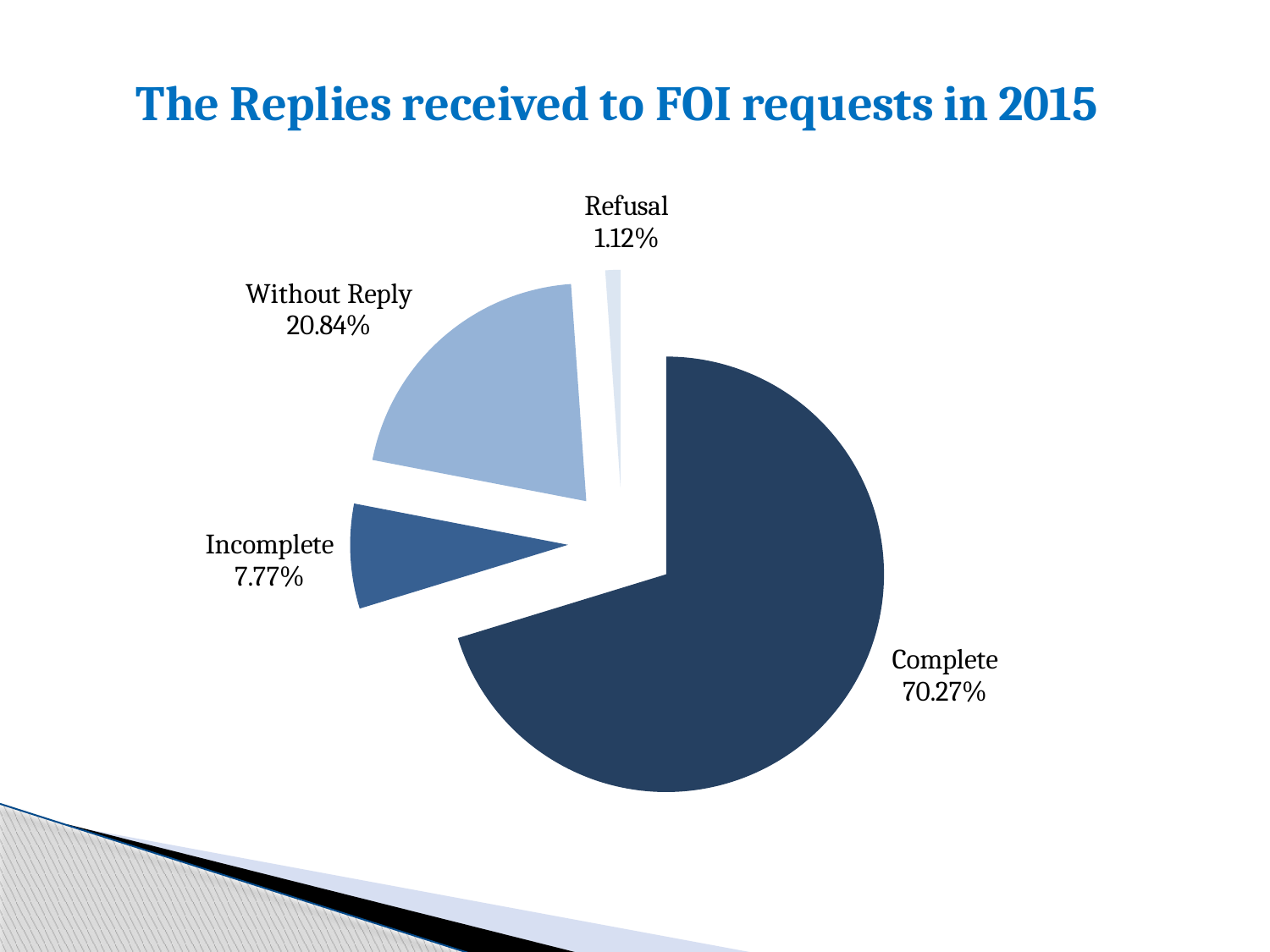
What kind of chart is shown on the slide? Pie chart Which category has the largest share of the pie? Complete Which category has the smallest share of the pie? Refusal What share of replies were Without Reply? 20.84% What share of replies were Incomplete? 7.77% How many categories are shown in the pie chart? 4 What share of replies were Complete? 70.27% Which is larger, the share for Without Reply or the share for Incomplete? Without Reply What share of replies were Refusal? 1.12% What is the difference in percentage points between Complete and Without Reply? 49.43 What is the difference in percentage points between Incomplete and Refusal? 6.65 What is the title of the chart? The Replies received to FOI requests in 2015